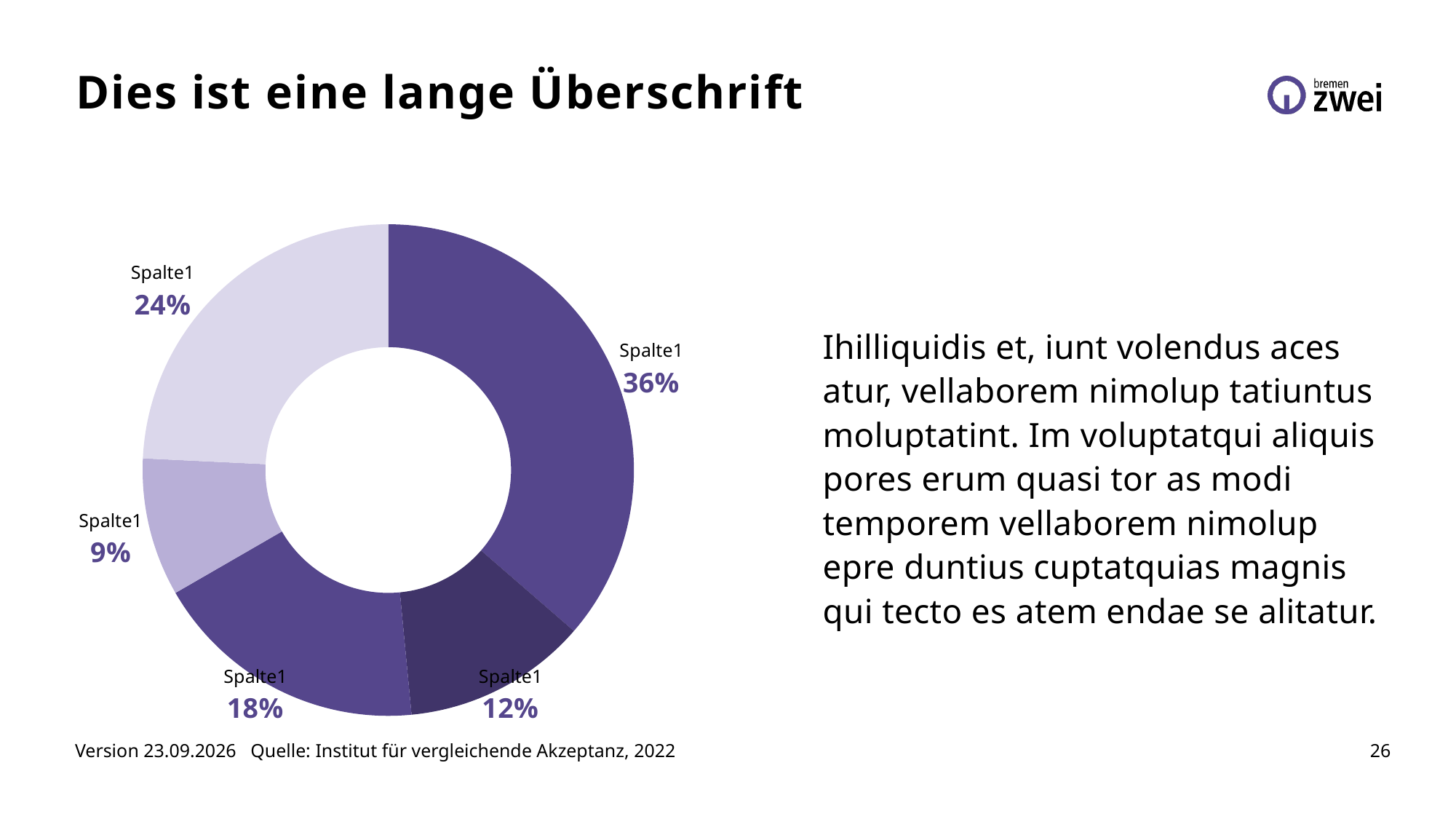
Which slice is larger: the bottom-left slice or the bottom-right slice? the bottom-left slice (18%) What percentage is shown for the lightest-coloured slice at the top left of the doughnut chart? 24% What percentage is shown for the slice on the right side of the doughnut chart? 36% What is the value of the smallest slice in the doughnut chart? 9% What percentage is shown for the slice at the bottom right of the doughnut chart? 12% What kind of chart is shown on the slide? doughnut chart What is the difference between the largest slice (36%) and the bottom-right slice (12%)? 24 percentage points What category label is shown next to each slice of the doughnut chart? Spalte1 What source is cited below the chart? Institut für vergleichende Akzeptanz, 2022 What percentage is shown for the slice at the bottom left of the doughnut chart? 18% How many slices does the doughnut chart have? 5 What is the value of the largest slice in the doughnut chart? 36%